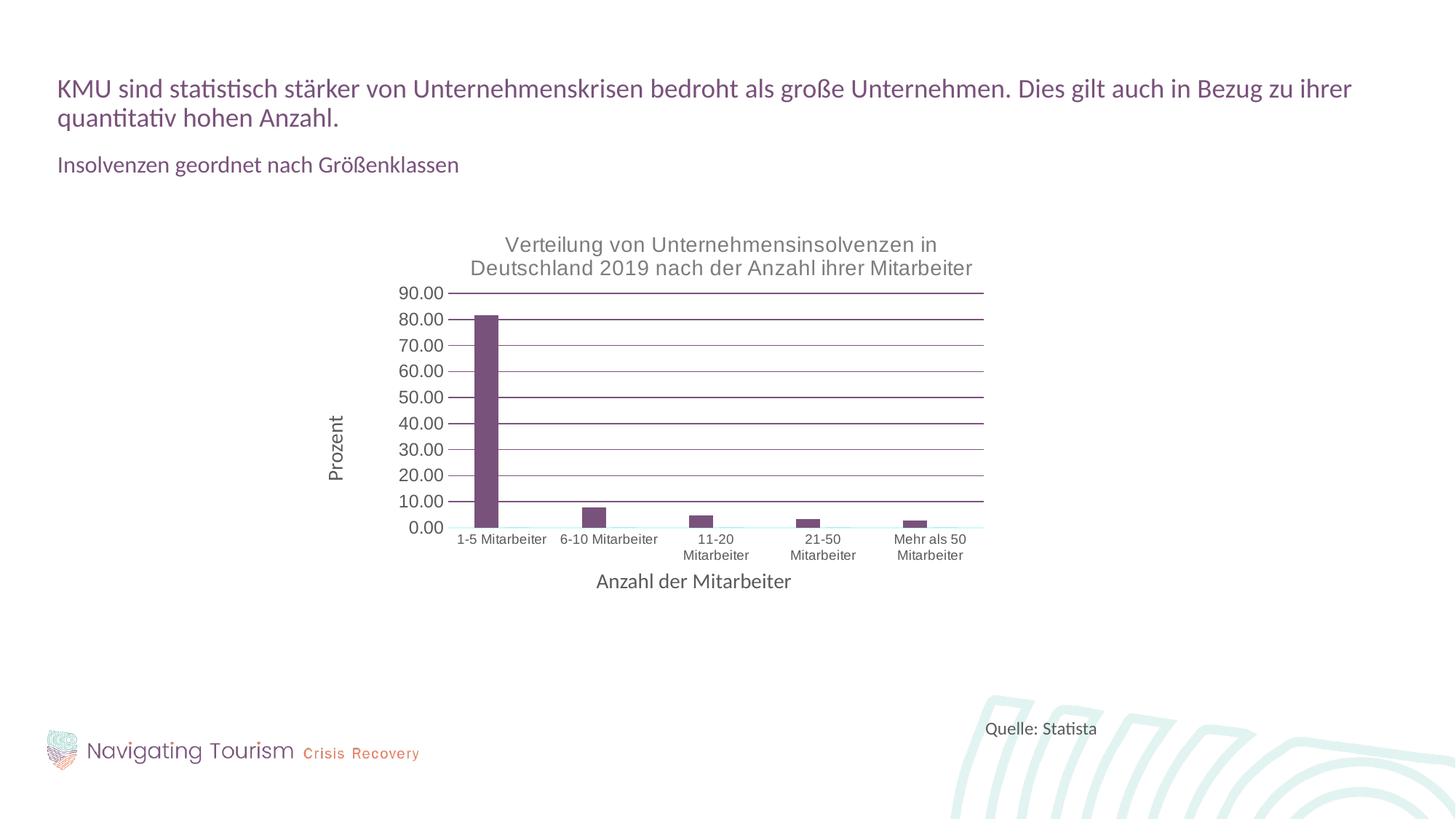
Which is larger, the value for 6-10 Mitarbeiter or the value for 11-20 Mitarbeiter? 6-10 Mitarbeiter Is the value for Mehr als 50 Mitarbeiter greater or less than 10.00? less Which category has the highest share of insolvencies in the chart? 1-5 Mitarbeiter Which is larger, the value for 1-5 Mitarbeiter or the value for 6-10 Mitarbeiter? 1-5 Mitarbeiter How many employee-size categories are shown on the x axis of the chart? 5 What kind of chart is shown on the slide? bar chart Is the value for 1-5 Mitarbeiter greater or less than 80.00? greater Is the value for 6-10 Mitarbeiter greater or less than 10.00? less What is the title of the chart? Verteilung von Unternehmensinsolvenzen in Deutschland 2019 nach der Anzahl ihrer Mitarbeiter What is the label of the y axis of the chart? Prozent Do the values rise or fall as you move from left to right along the x axis? fall